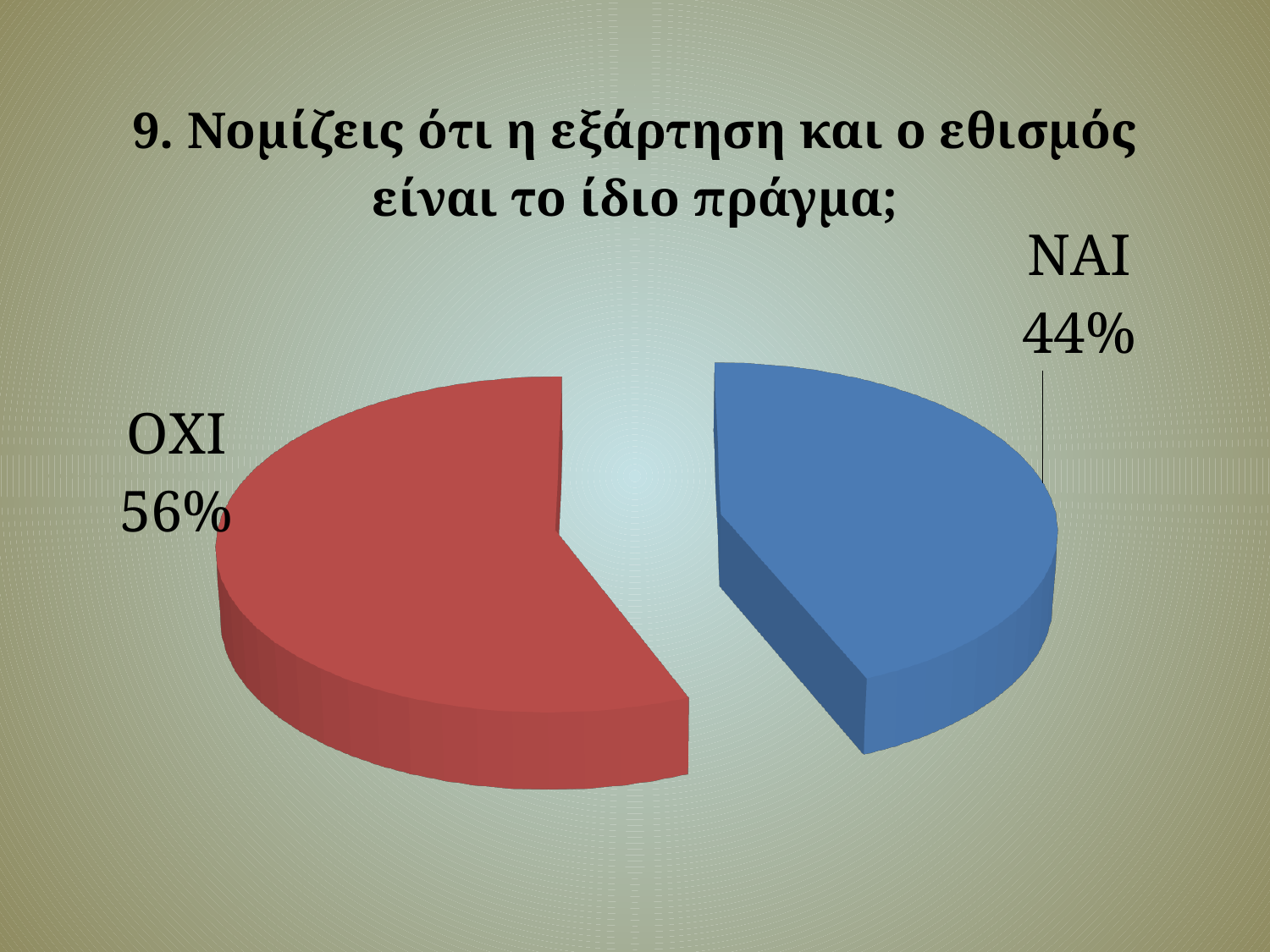
What colour is the ΟΧΙ slice? red How many slices does the pie chart have? 2 Which slice is the largest? ΟΧΙ Which slice is the smallest? ΝΑΙ What kind of chart is shown on the slide? pie chart What is the difference in percentage points between ΟΧΙ and ΝΑΙ? 12 What colour is the ΝΑΙ slice? blue Which is larger, ΝΑΙ or ΟΧΙ? ΟΧΙ Is the value for ΝΑΙ greater or less than 50%? less What share of the pie does ΟΧΙ have? 56% What share of the pie does ΝΑΙ have? 44%